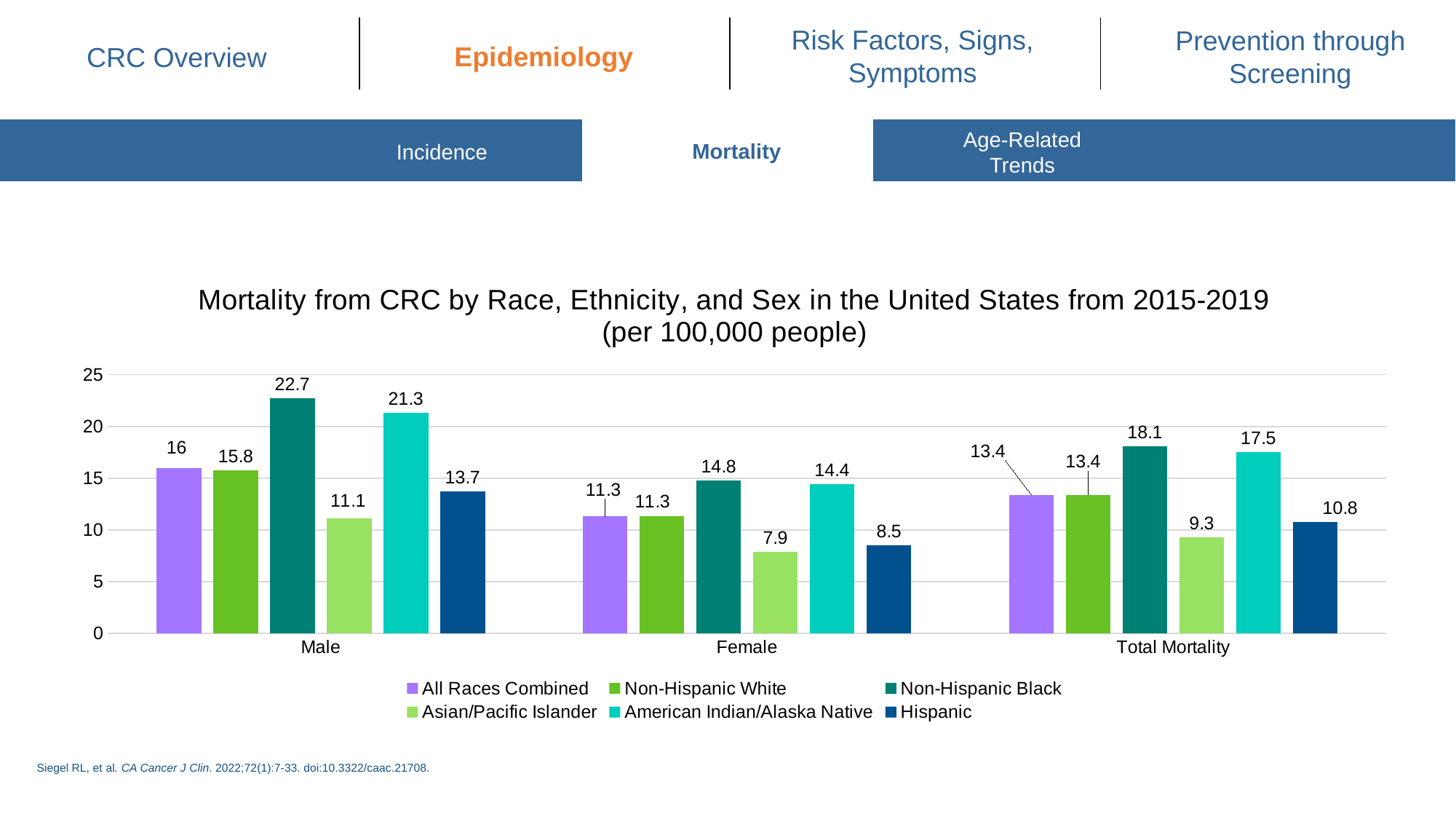
Is the mortality rate for Hispanic females greater or less than 10? less What is the mortality rate for Asian/Pacific Islander females? 7.9 What is the difference between the Non-Hispanic Black and Non-Hispanic White mortality rates for males? 6.9 Which series has the lowest mortality rate in the Female group? Asian/Pacific Islander How many series does the legend list? 6 Which is larger: the Total Mortality value for American Indian/Alaska Native or for Non-Hispanic Black? Non-Hispanic Black Which series has the highest mortality rate in the Male group? Non-Hispanic Black What is the title of the chart? Mortality from CRC by Race, Ethnicity, and Sex in the United States from 2015-2019 (per 100,000 people) What is the Total Mortality value for Hispanic people? 10.8 What kind of chart is shown on the slide? bar chart What is the mortality rate for Non-Hispanic Black males? 22.7 How many categories are shown on the x axis? 3